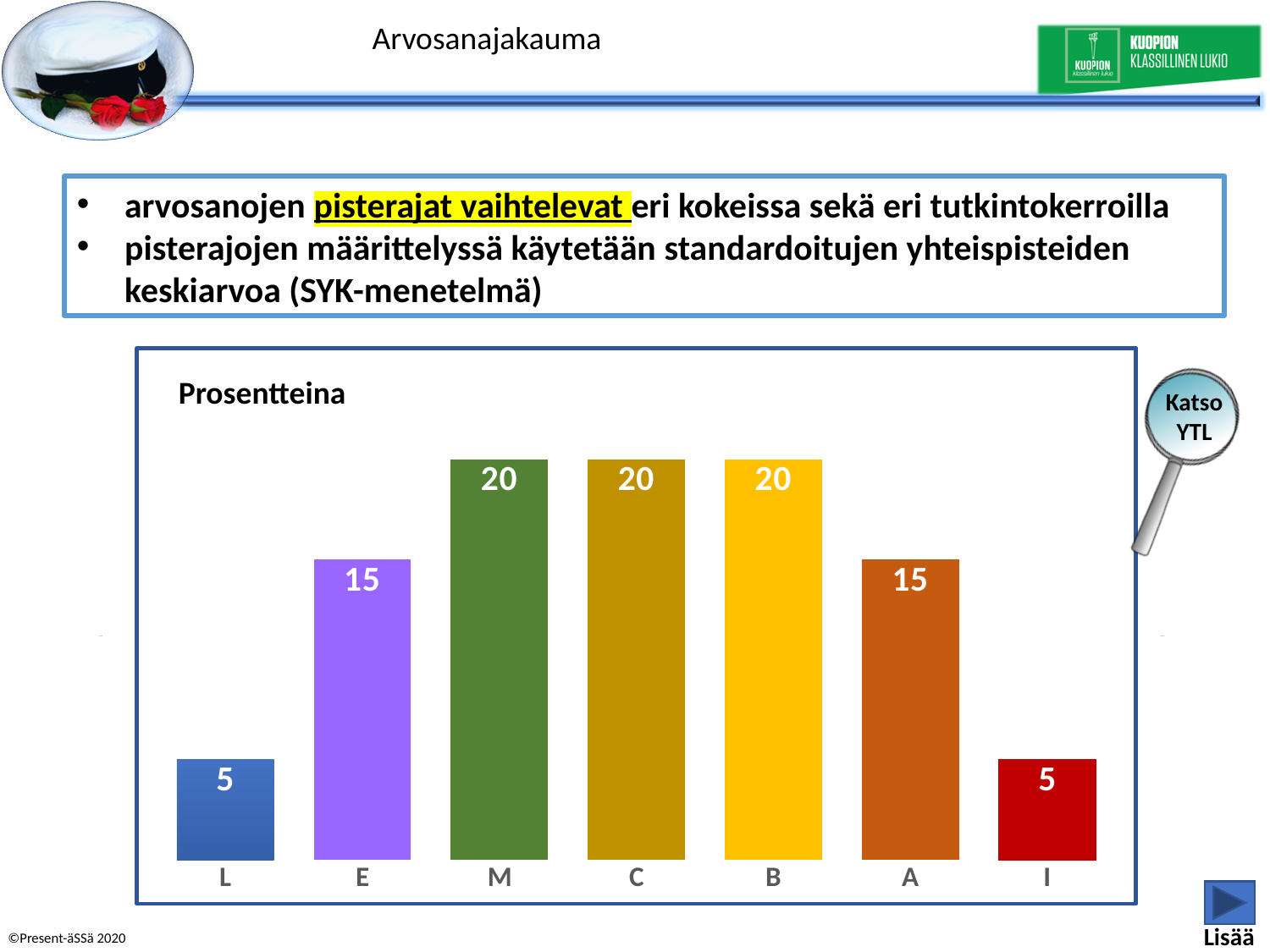
What is the value for grade I? 5 What is the value for grade M? 20 What kind of chart is shown? bar chart What is the value for grade A? 15 What is the value for grade E? 15 How many grade categories are shown on the x axis? 7 What is the total of the values for L, E and M? 40 What label appears above the chart indicating the unit of the values? Prosentteina What is the difference between the values for A and I? 10 What is the difference between the values for M and E? 5 What is the value for grade L? 5 Which is larger, the value for C or the value for A? C